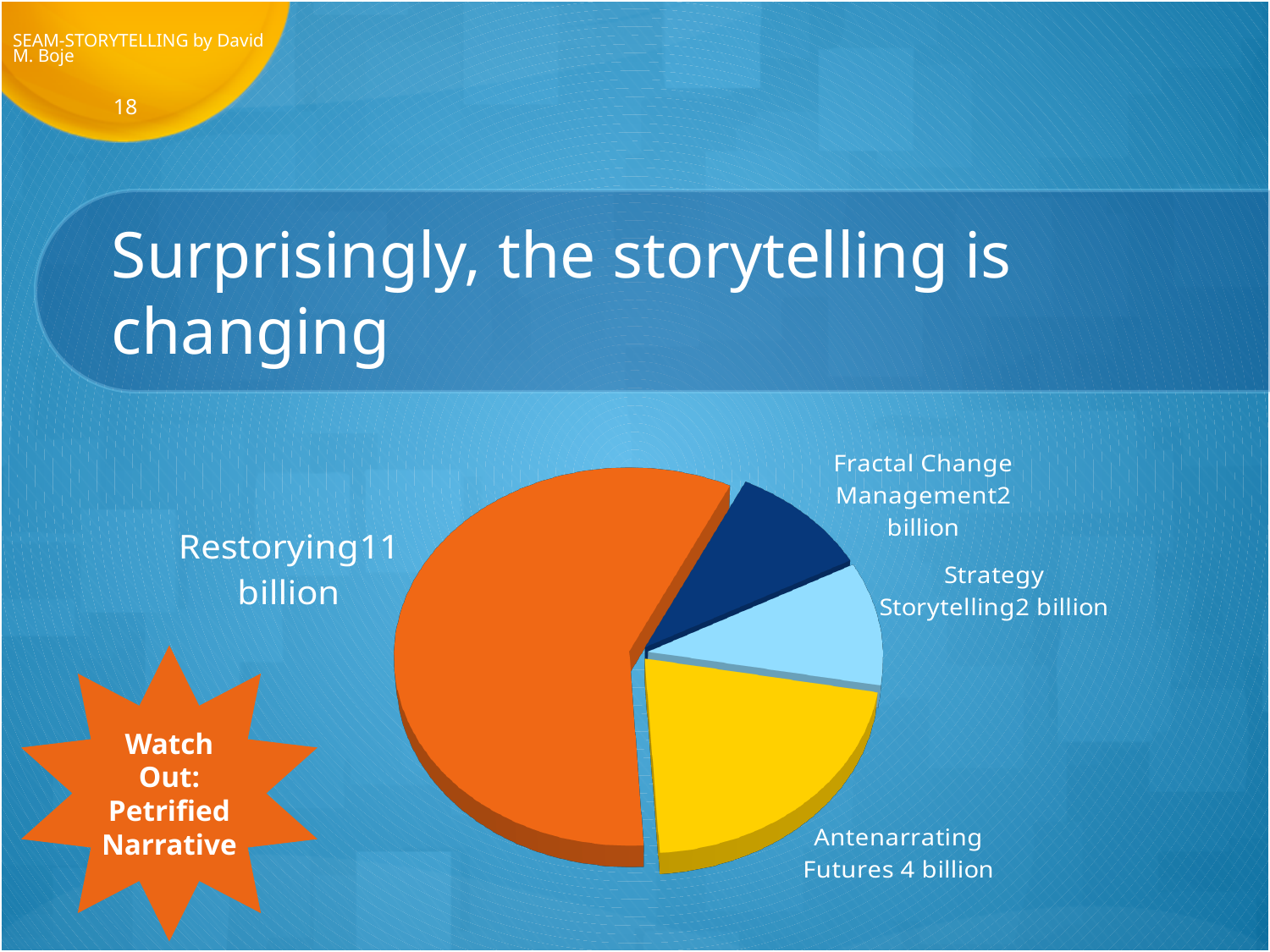
How many slices does the pie chart have? 4 What is the difference between the Restorying value and the Antenarrating Futures value? 7 billion What value is shown for Restorying in the pie chart? 11 billion What value is shown for Strategy Storytelling in the pie chart? 2 billion What value is shown for Antenarrating Futures in the pie chart? 4 billion What kind of chart is shown on the slide? Pie chart What value is shown for Fractal Change Management in the pie chart? 2 billion Which is larger, Antenarrating Futures or Strategy Storytelling? Antenarrating Futures Which category has the largest slice in the pie chart? Restorying Which two categories share the smallest value in the pie chart? Fractal Change Management and Strategy Storytelling What is the total of all four slices in the pie chart? 19 billion What colour is the Antenarrating Futures slice in the pie chart? Yellow